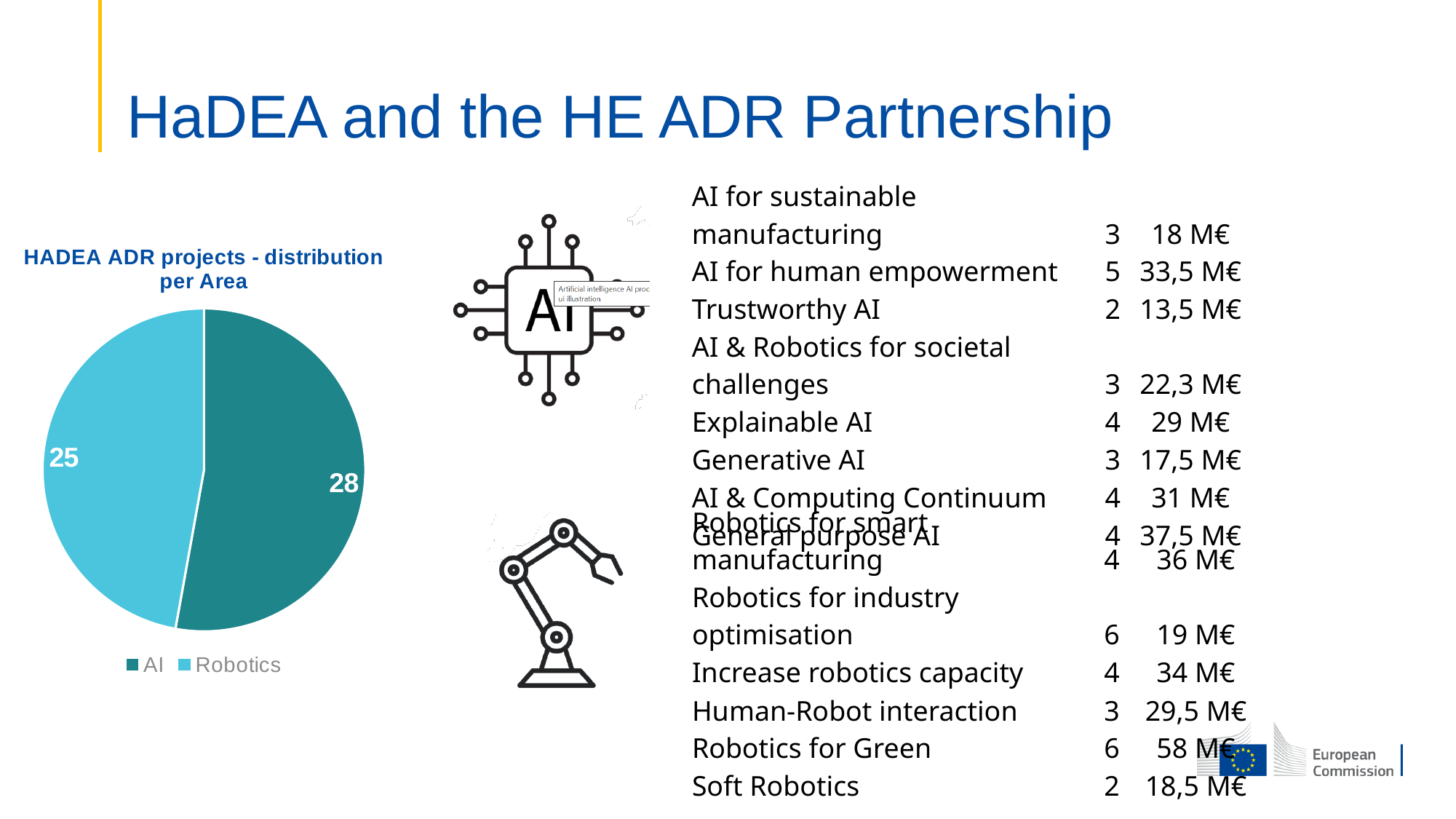
Which area has the smaller slice in the pie chart? Robotics How many entries does the pie chart's legend list? 2 Which legend entry is shown in the lighter blue colour in the pie chart? Robotics What type of chart is shown on the slide? pie chart What is the difference between the AI and Robotics values in the pie chart? 3 How many slices does the pie chart have? 2 What is the title of the pie chart? HADEA ADR projects - distribution per Area What is the value for Robotics in the pie chart? 25 What is the value for AI in the pie chart? 28 Which area has the larger slice in the pie chart? AI What is the total of the two slices in the pie chart? 53 Is the value for AI larger or smaller than the value for Robotics in the pie chart? larger